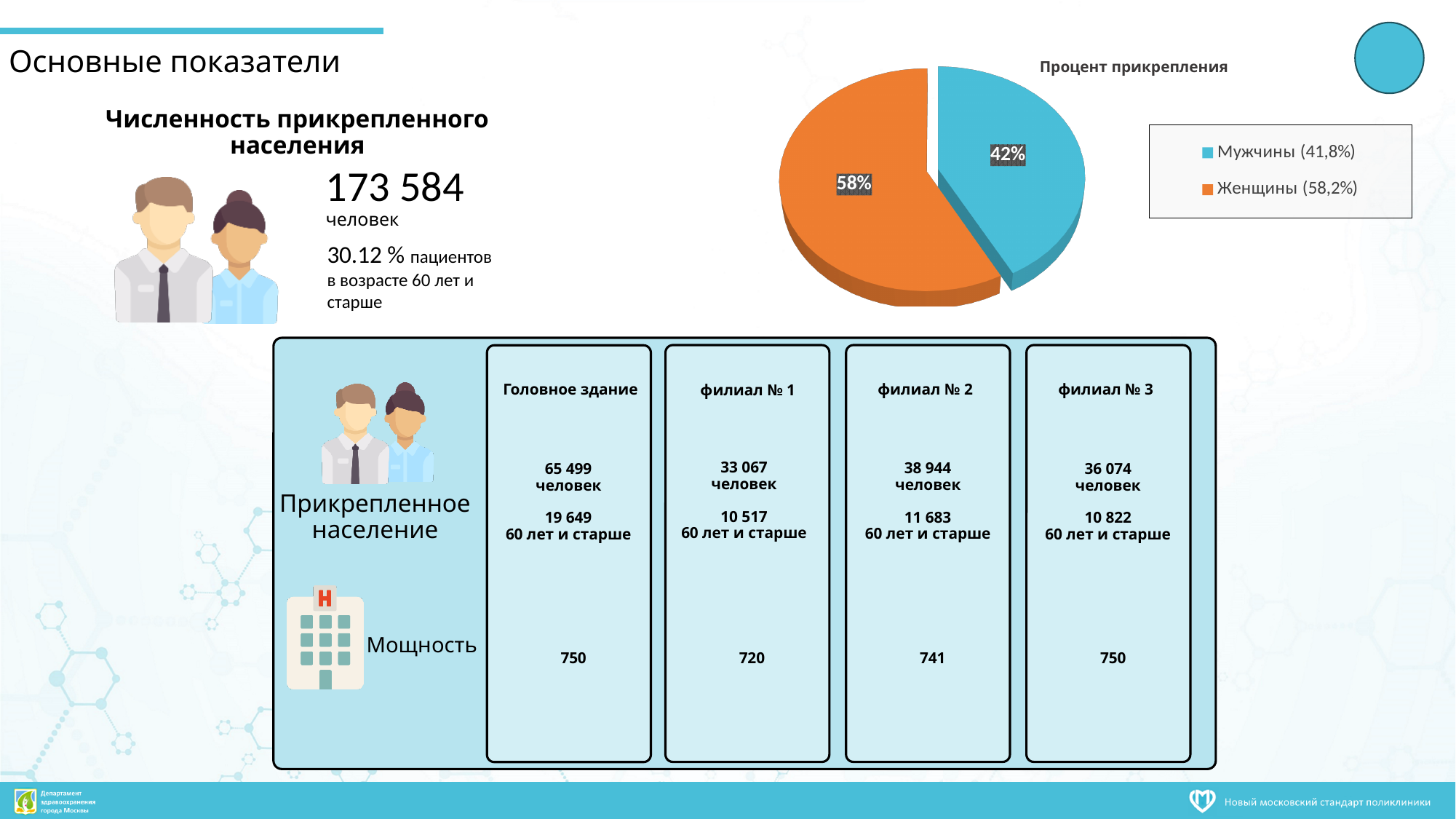
By how many percentage points does the Женщины slice exceed the Мужчины slice, using the labels on the pie? 16 How many slices does the pie chart have? 2 What is the title of the pie chart? Процент прикрепления What share of the pie does the Женщины slice take? 58% Which slice is larger, Мужчины or Женщины? Женщины What percentage is given for Мужчины in the legend of the pie chart? 41,8% How many entries does the legend of the pie chart list? 2 What kind of chart is shown on the slide? pie chart Which category has the largest slice in the pie chart? Женщины What colour is the Женщины slice in the pie chart? orange Which category has the smallest slice in the pie chart? Мужчины What share of the pie does the Мужчины slice take? 42%